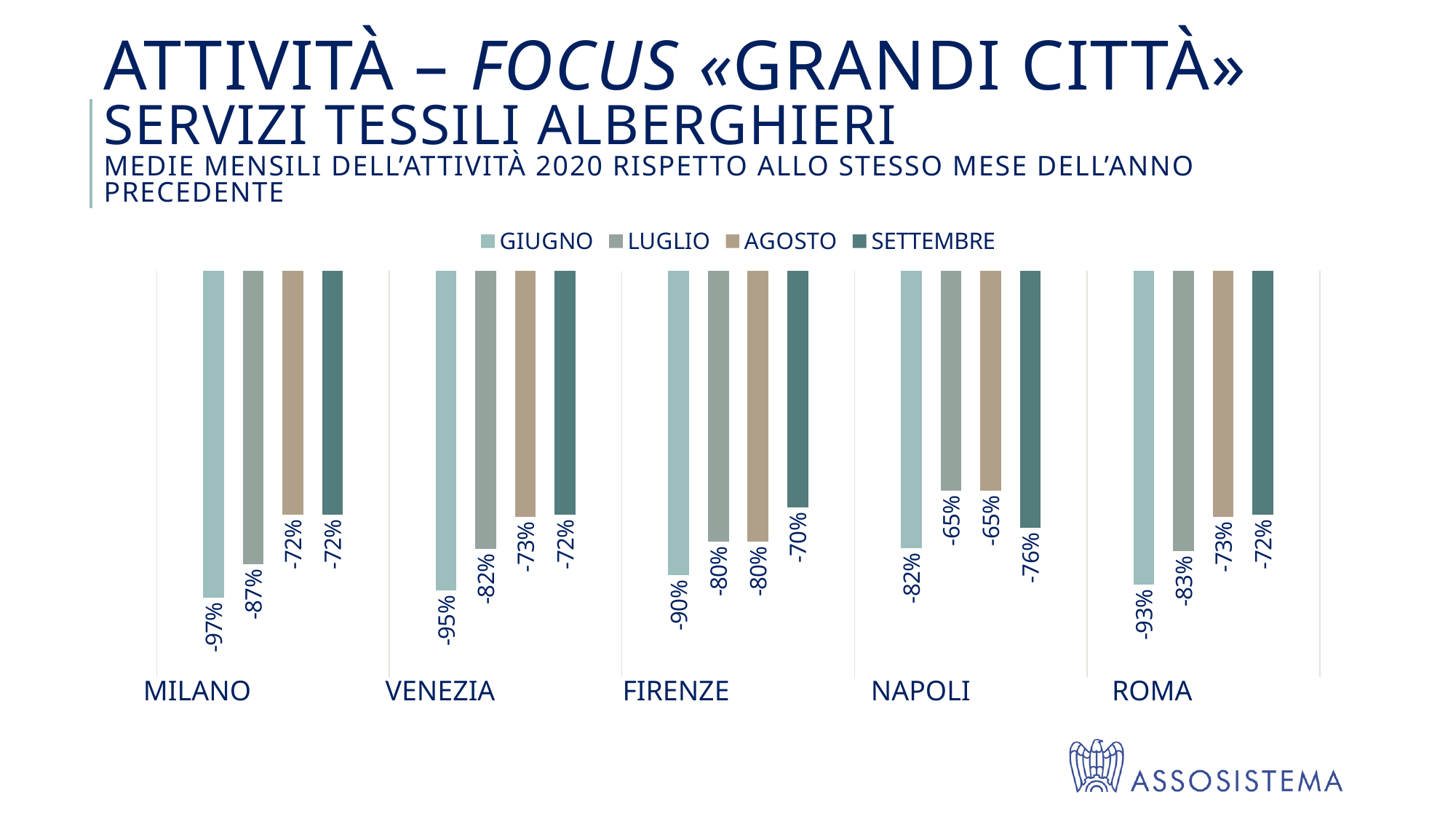
What kind of chart is shown on the slide? Bar chart How many series does the legend list? 4 Which month is shown in the lightest blue-green colour in the legend? Giugno What is the value for Settembre in Firenze? -70% Which city has the most negative Giugno value? Milano How many cities are shown on the x axis? 5 What is the value for Giugno in Milano? -97% What is the difference between the Giugno and Luglio values for Venezia? 13 percentage points What is the value for Luglio in Napoli? -65% Which is more negative, the Settembre value for Napoli or the Settembre value for Roma? Napoli What is the value for Agosto in Roma? -73% Which city has the least negative Luglio value? Napoli